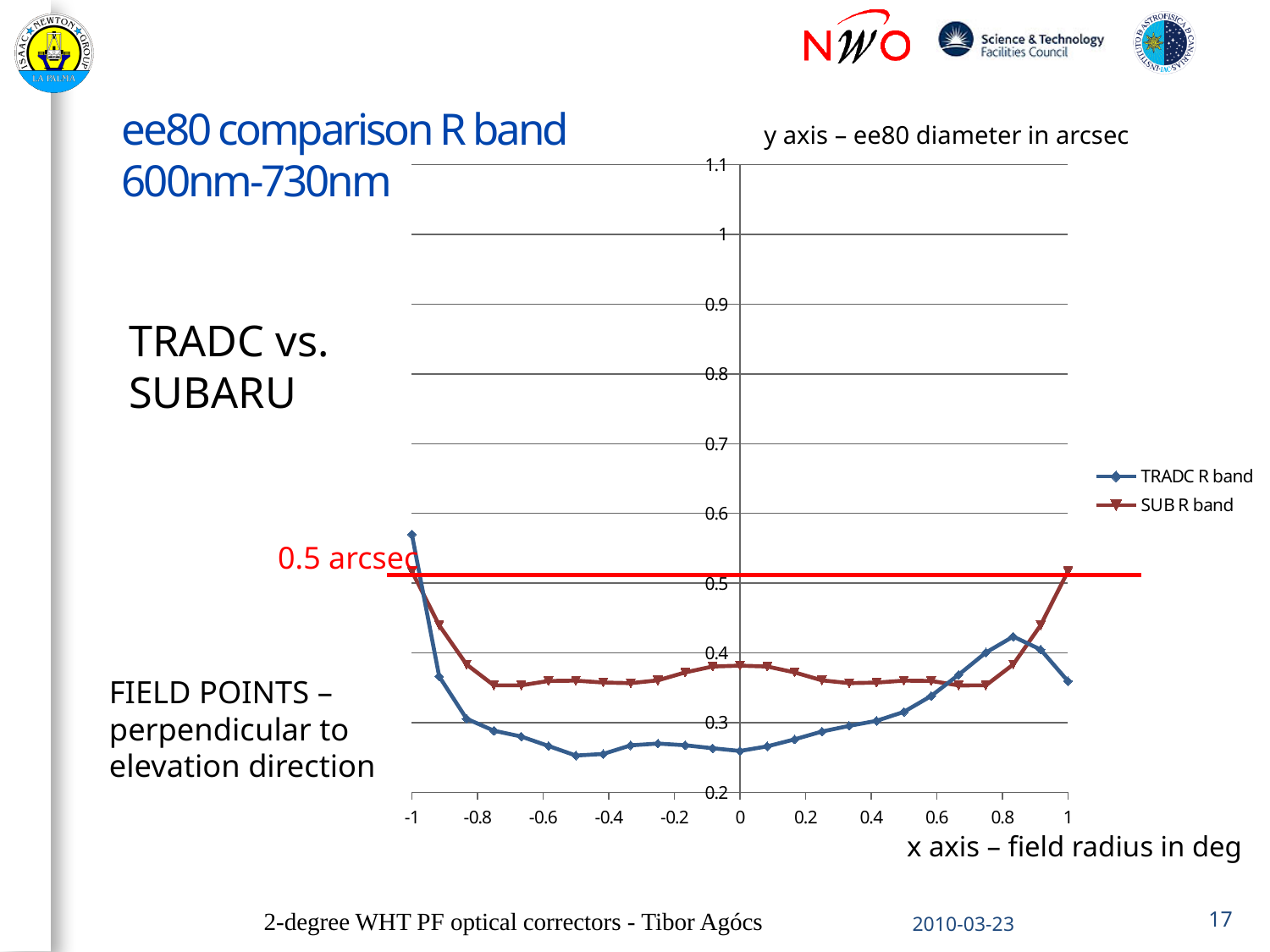
What kind of chart is shown on the slide? line chart Is the value of TRADC R band at field radius -1 greater or less than 0.5? greater How many series does the chart legend list? 2 According to the slide, what quantity is plotted on the y axis of the chart? ee80 diameter in arcsec Does the SUB R band series rise or fall as the field radius goes from 0.8 to 1? rise What are the two series named in the chart legend? TRADC R band and SUB R band At field radius 1, which series has the larger value, TRADC R band or SUB R band? SUB R band Is the value of TRADC R band at field radius 0 greater or less than 0.3? less Does the TRADC R band series rise or fall as the field radius goes from -1 to -0.5? fall Is the value of SUB R band at field radius -0.9 greater or less than 0.4? greater At field radius 0, which series has the larger value, TRADC R band or SUB R band? SUB R band